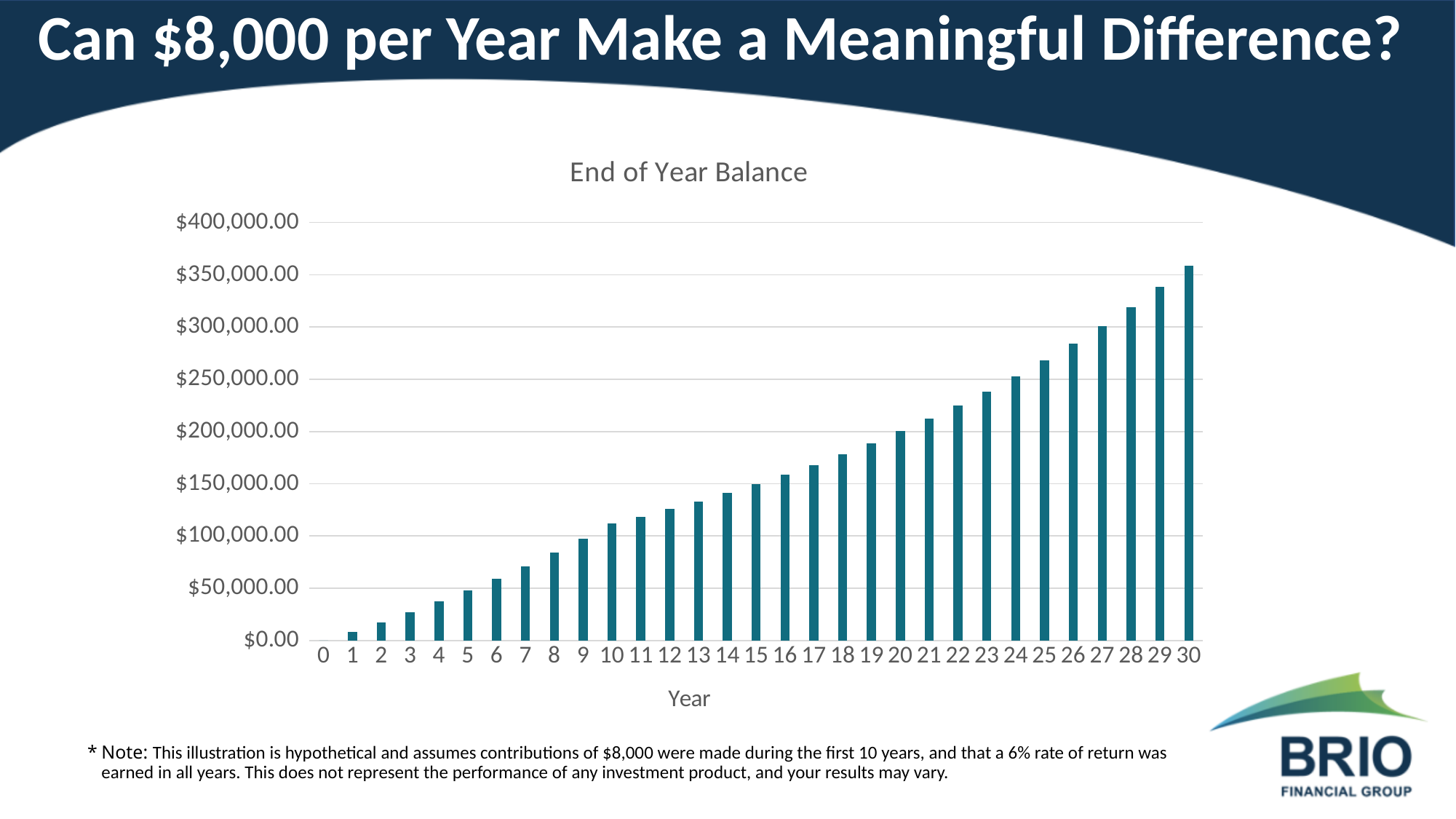
Which year has the larger end of year balance, year 12 or year 22? 22 How many year categories are labelled on the x axis? 31 What kind of chart is shown on the slide? bar chart What is the title of the chart? End of Year Balance Is the value for year 8 greater or less than $100,000.00? less Is the value for year 30 greater or less than $300,000.00? greater Do the end of year balances rise or fall as the years increase along the x axis? rise What is the label of the x axis? Year Which year has the shortest visible bar in the chart? 1 Which year has the tallest bar in the chart? 30 Is the value for year 10 greater or less than $100,000.00? greater